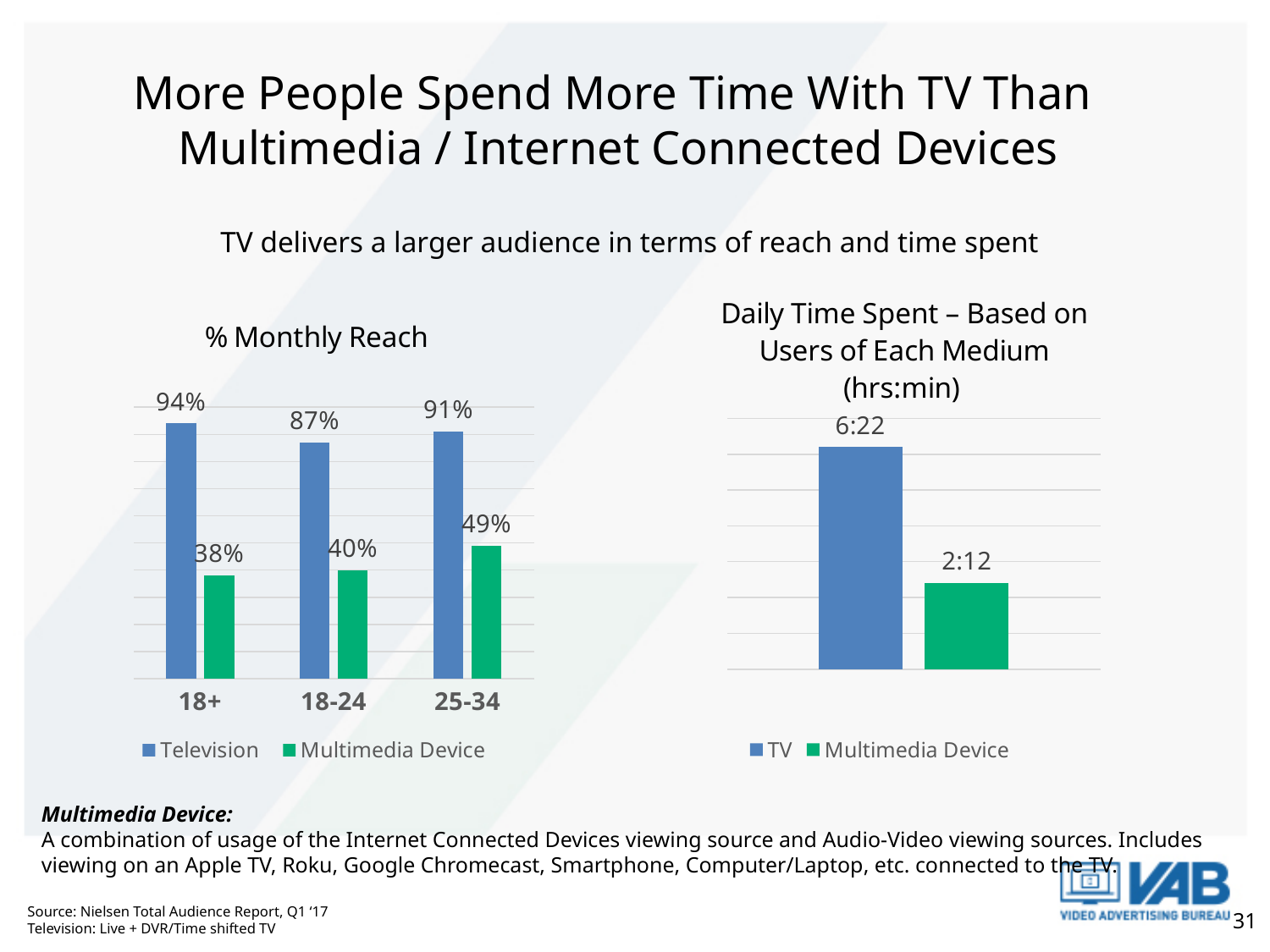
In the 'Daily Time Spent' chart, what is the value for Multimedia Device? 2:12 What kind of chart is the 'Daily Time Spent' chart on the right? Bar chart In the 'Daily Time Spent' chart, which is larger, TV or Multimedia Device? TV In the '% Monthly Reach' chart, what is the Television value for the 18+ group? 94% In the '% Monthly Reach' chart, what is the difference between the Television and Multimedia Device values for the 25-34 group? 42% In the '% Monthly Reach' chart, what is the Multimedia Device value for the 25-34 group? 49% In the '% Monthly Reach' chart, how many series does the legend list? 2 In the '% Monthly Reach' chart, which age group has the lowest Multimedia Device reach? 18+ In the 'Daily Time Spent' chart, what is the value for TV? 6:22 In the '% Monthly Reach' chart, how many age groups are shown on the x axis? 3 In the '% Monthly Reach' chart, which age group has the highest Television reach? 18+ In the '% Monthly Reach' chart, what is the Multimedia Device value for the 18-24 group? 40%